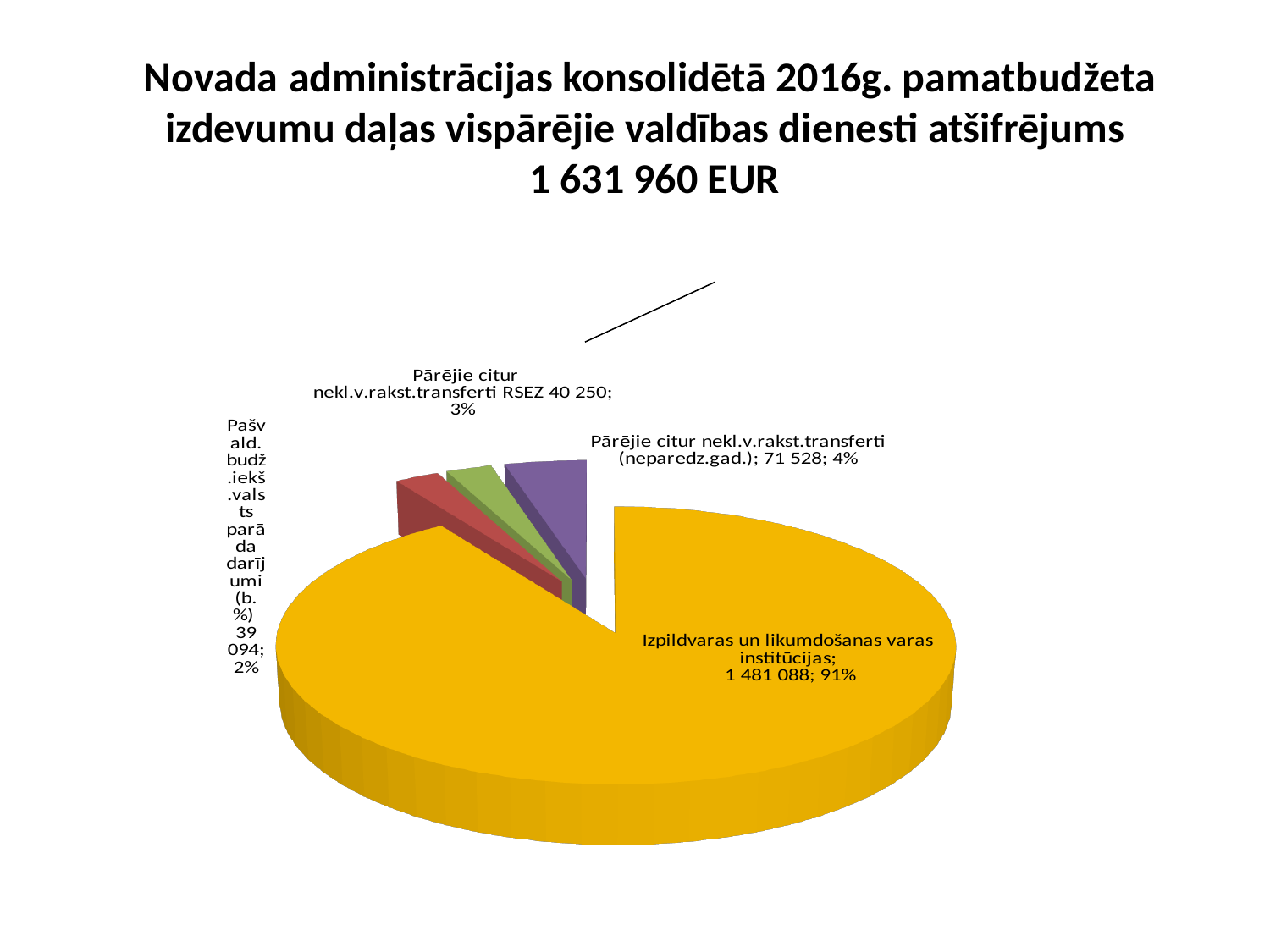
What kind of chart is shown on the slide? Pie chart What share of the pie does Pašvald.budž.iekš.valsts parāda darījumi (b.%) represent? 2% What is the value for Izpildvaras un likumdošanas varas institūcijas? 1 481 088 What is the value for Pārējie citur nekl.v.rakst.transferti (neparedz.gad.)? 71 528 What is the value for Pārējie citur nekl.v.rakst.transferti RSEZ? 40 250 What share of the pie does Izpildvaras un likumdošanas varas institūcijas represent? 91% How many slices does the pie chart have? 4 What is the difference between the values for Pārējie citur nekl.v.rakst.transferti (neparedz.gad.) and Pārējie citur nekl.v.rakst.transferti RSEZ? 31 278 Which category has the largest slice of the pie? Izpildvaras un likumdošanas varas institūcijas What share of the pie does Pārējie citur nekl.v.rakst.transferti (neparedz.gad.) represent? 4% Which is larger: the value for Pārējie citur nekl.v.rakst.transferti RSEZ or the value for Pašvald.budž.iekš.valsts parāda darījumi (b.%)? Pārējie citur nekl.v.rakst.transferti RSEZ Which category has the smallest slice of the pie? Pašvald.budž.iekš.valsts parāda darījumi (b.%)